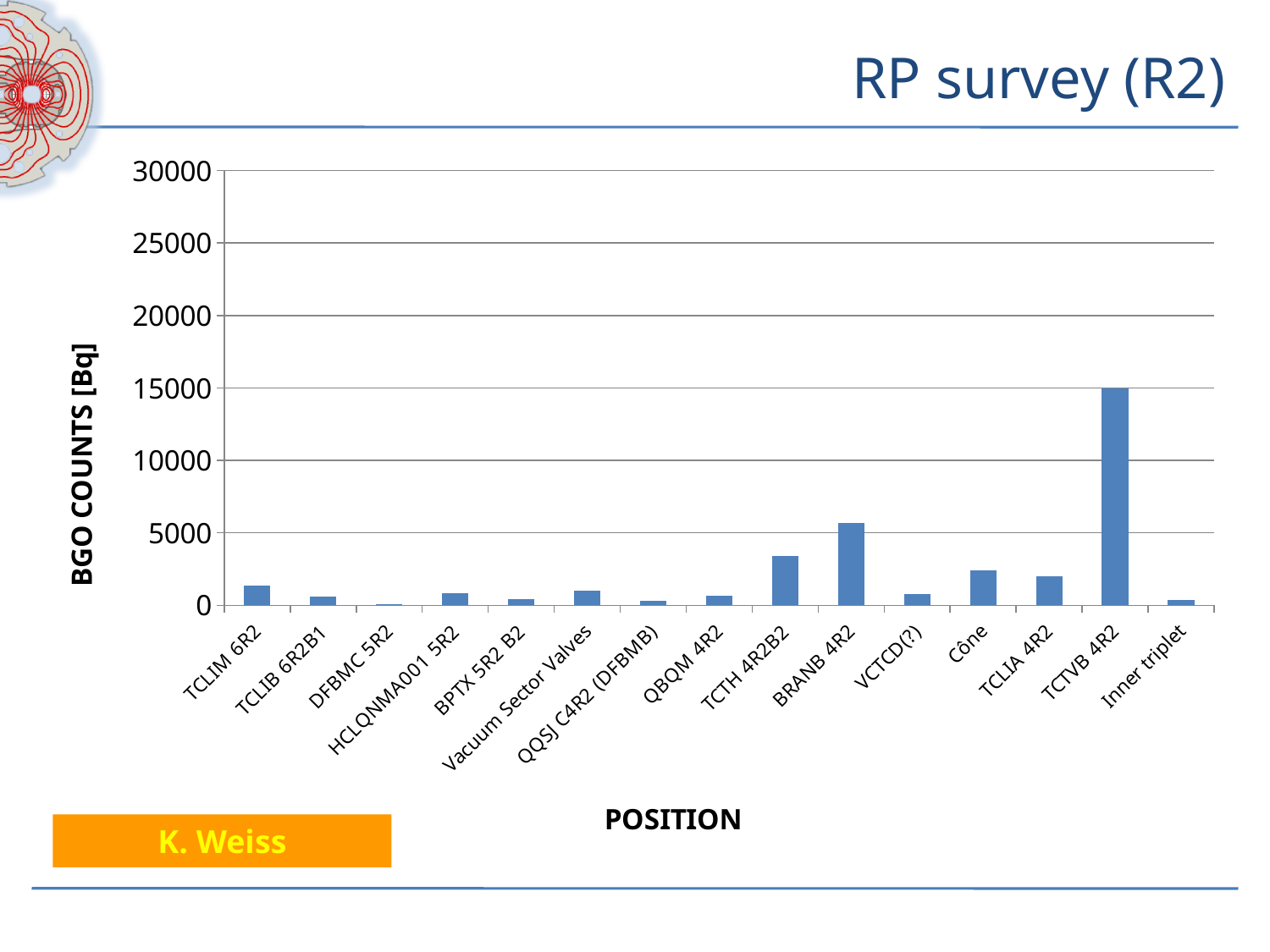
Is the value for TCTH 4R2B2 greater or less than 5000? less Which has the larger BGO counts, TCLIM 6R2 or TCLIB 6R2B1? TCLIM 6R2 What kind of chart is shown on the slide? bar chart Which has the larger BGO counts, BRANB 4R2 or TCTH 4R2B2? BRANB 4R2 What is the label of the horizontal axis? POSITION Is the value for TCTVB 4R2 greater or less than 10000? greater What is the label of the vertical axis? BGO COUNTS [Bq] Which position has the lowest BGO counts? DFBMC 5R2 How many positions are plotted on the x axis? 15 Is the value for BRANB 4R2 greater or less than 5000? greater Which position has the highest BGO counts? TCTVB 4R2